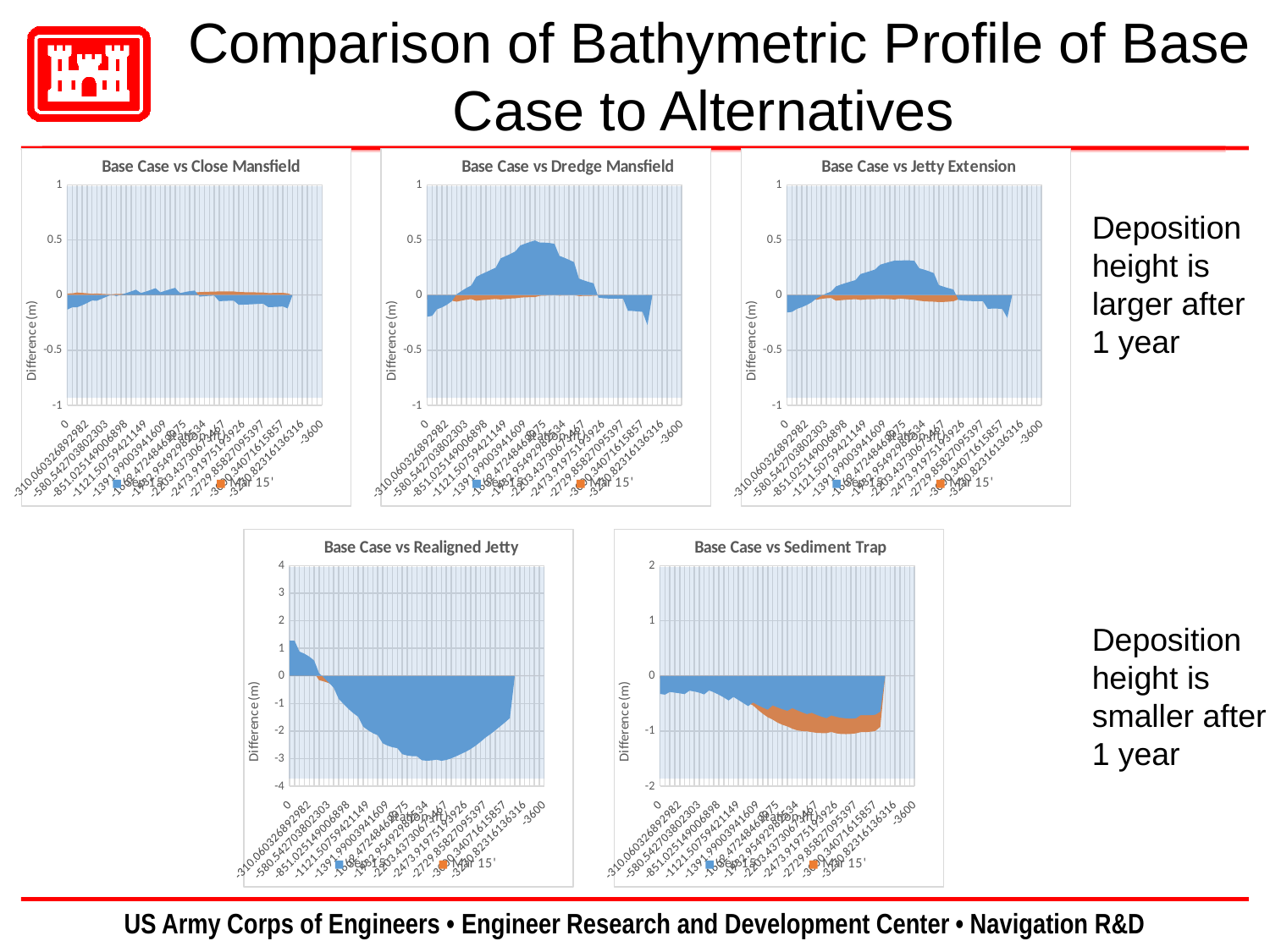
What is the y-axis label on the "Base Case vs Realigned Jetty" chart? Difference (m) In the "Base Case vs Realigned Jetty" chart, is the lowest point of the blue area greater or less than -2? less In the "Base Case vs Jetty Extension" chart, what is the maximum value shown on the y axis? 1 How many series does the legend list in the "Base Case vs Close Mansfield" chart? 2 What kind of chart is "Base Case vs Dredge Mansfield"? Area chart In the "Base Case vs Sediment Trap" chart, is the lowest point of the orange area greater or less than -0.5? less In the "Base Case vs Realigned Jetty" chart, is the value of the blue area at the left end of the x axis greater or less than 0? greater What is the title of the chart in the top-left position of the slide? Base Case vs Close Mansfield In the "Base Case vs Sediment Trap" chart, what is the minimum value shown on the y axis? -2 In the "Base Case vs Realigned Jetty" chart, what is the maximum value shown on the y axis? 4 How many charts are shown on the slide? 5